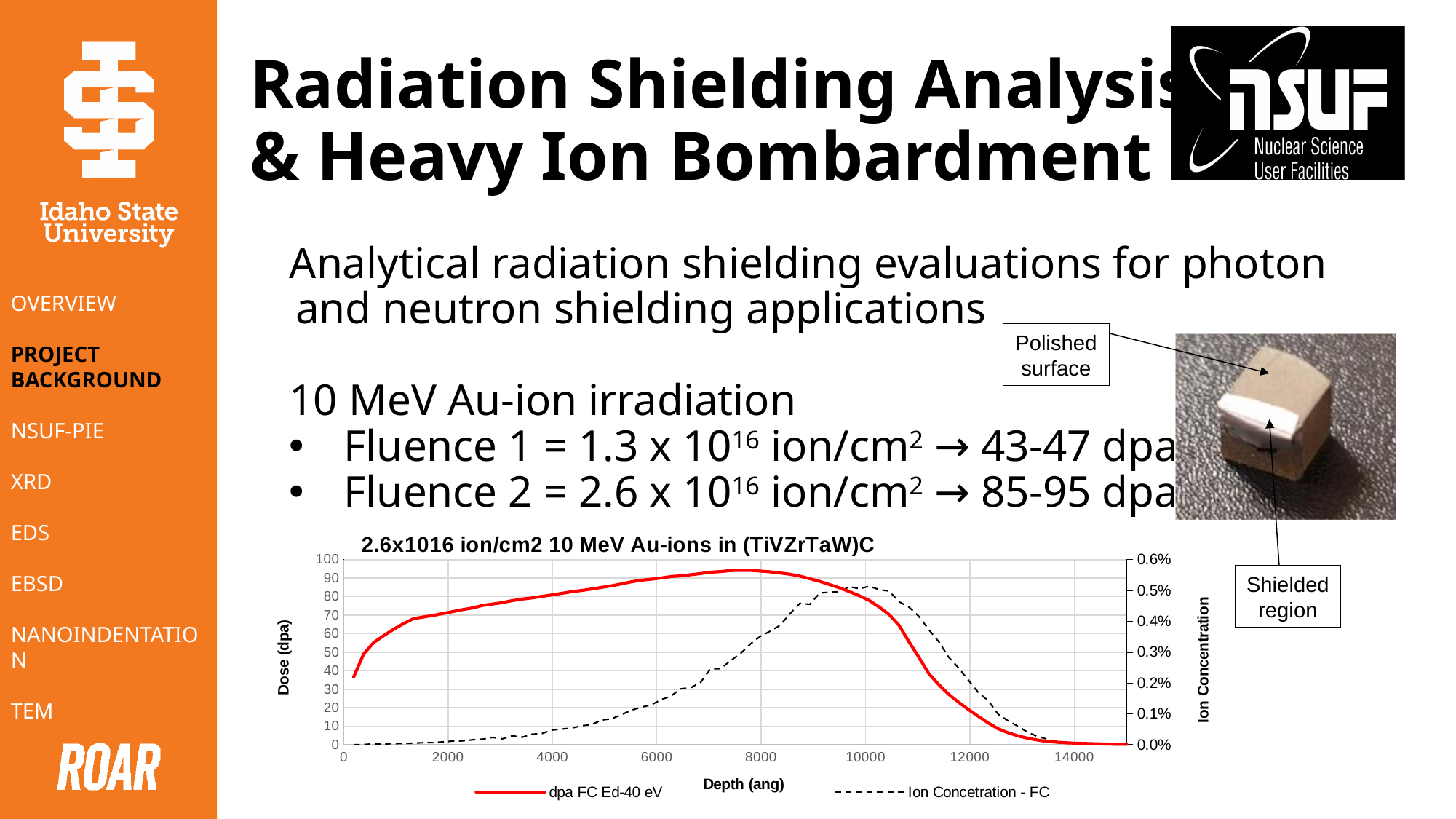
Is the dpa FC Ed-40 eV value at a depth of 2000 ang greater or less than 60 dpa? greater What is the title of the chart? 2.6x1016 ion/cm2 10 MeV Au-ions in (TiVZrTaW)C Is the dpa FC Ed-40 eV value at a depth of 8000 ang greater or less than 80 dpa? greater Between depths of 0 and 6000 ang, does the dpa FC Ed-40 eV curve rise or fall? rise What kind of chart is shown on the slide? line chart Is the dpa FC Ed-40 eV value at a depth of 12000 ang greater or less than 40 dpa? less How many series does the chart legend list? 2 Between depths of 10000 and 14000 ang, does the dpa FC Ed-40 eV curve rise or fall? fall Which series is drawn as a dashed line in the chart? Ion Concetration - FC At a depth of 6000 ang, which series is higher relative to its own axis: dpa FC Ed-40 eV or Ion Concetration - FC? dpa FC Ed-40 eV